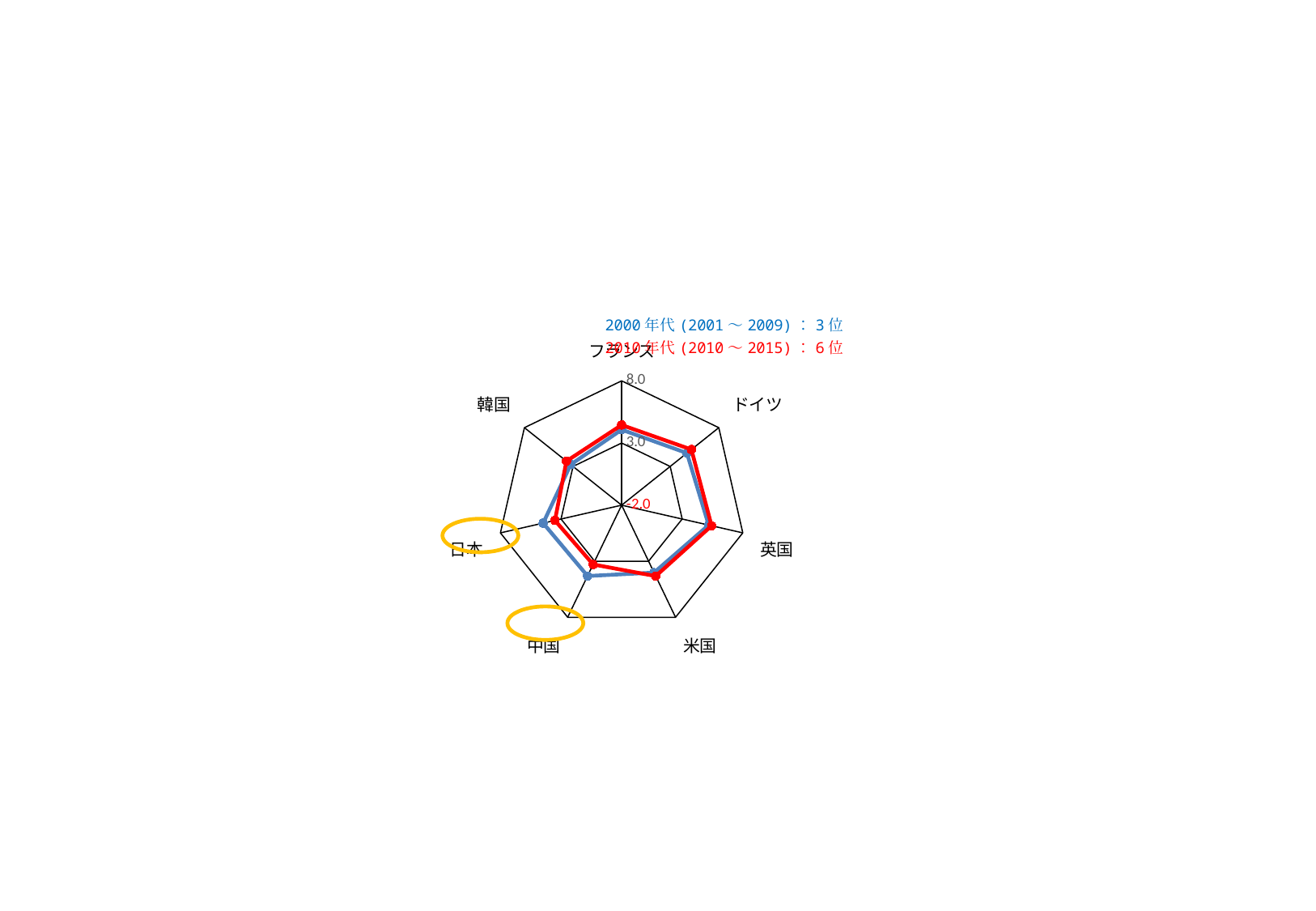
Is the 2010年代 value for フランス greater or less than 3.0? greater For 日本, which series has the larger value, 2000年代 or 2010年代? 2000年代 Is the 2010年代 value for 米国 greater or less than 8.0? less How many series does the legend list? 2 For 中国, which series has the larger value, 2000年代 or 2010年代? 2000年代 Which two country labels are circled in yellow on the chart? 日本 and 中国 Is the 2000年代 value for 日本 greater or less than 3.0? greater What kind of chart is shown on the slide? radar chart How many categories (countries) are plotted on the radar chart? 7 What colour is the line for the 2010年代 (2010～2015) series? red